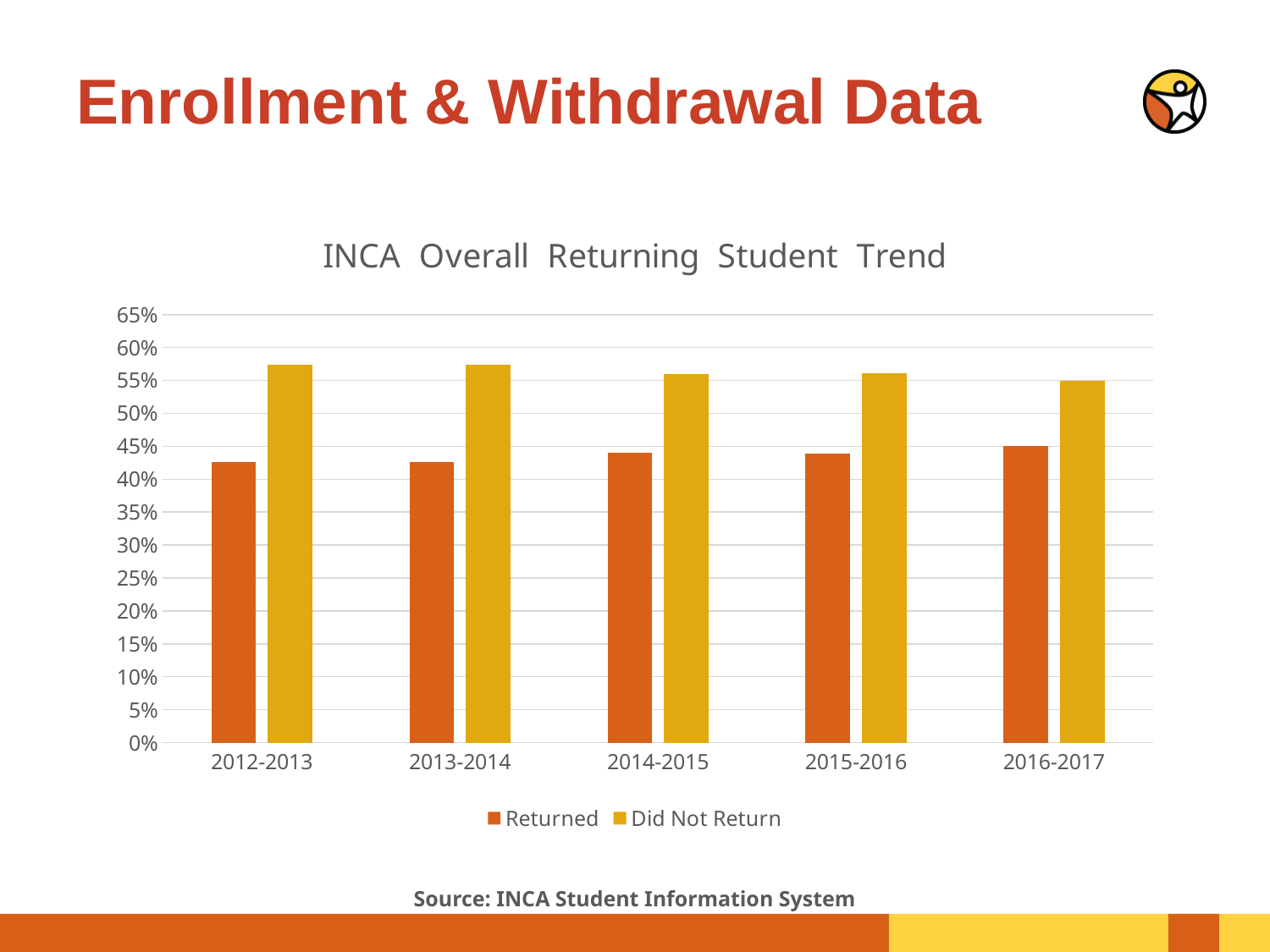
Does the Did Not Return series generally rise or fall from 2012-2013 to 2016-2017? fall Is the Returned value for 2013-2014 greater or less than 40%? greater What is the title of the chart? INCA Overall Returning Student Trend How many school years are shown on the x axis? 5 Is the Did Not Return value for 2015-2016 greater or less than 60%? less Which series is larger in 2012-2013, Returned or Did Not Return? Did Not Return How many series does the legend list? 2 Is the Did Not Return value for 2012-2013 greater or less than 55%? greater What source is cited below the chart? INCA Student Information System What type of chart is shown on the slide? Bar chart Which series is larger in 2016-2017, Returned or Did Not Return? Did Not Return